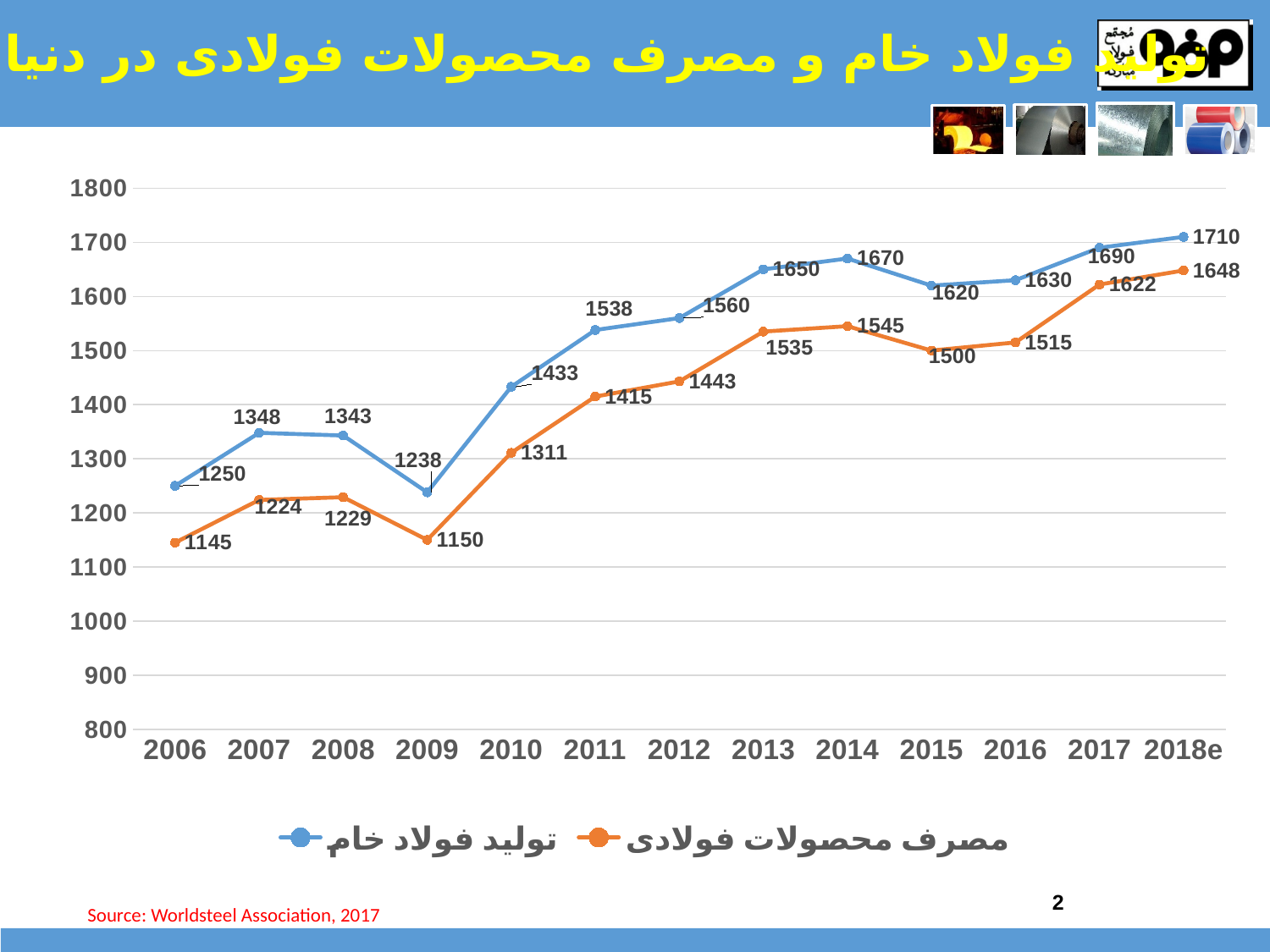
In which year is the orange line (مصرف محصولات فولادی) at its lowest? 2006 In which year is the blue line (تولید فولاد خام) at its highest? 2018e What is the value of the orange line (مصرف محصولات فولادی) in 2009? 1150 What type of chart is shown on the slide? line chart Which is larger for the blue line (تولید فولاد خام): the value in 2015 or the value in 2014? 2014 What is the value of the blue line (تولید فولاد خام) in 2014? 1670 Does the blue line (تولید فولاد خام) rise or fall from 2008 to 2009? fall How many years are shown on the x axis? 13 Is the value of the orange line (مصرف محصولات فولادی) in 2012 greater or less than 1400? greater What is the difference between the blue line (تولید فولاد خام) and the orange line (مصرف محصولات فولادی) in 2017? 68 How many series does the legend list? 2 What is the value of the blue line (تولید فولاد خام) in 2018e? 1710